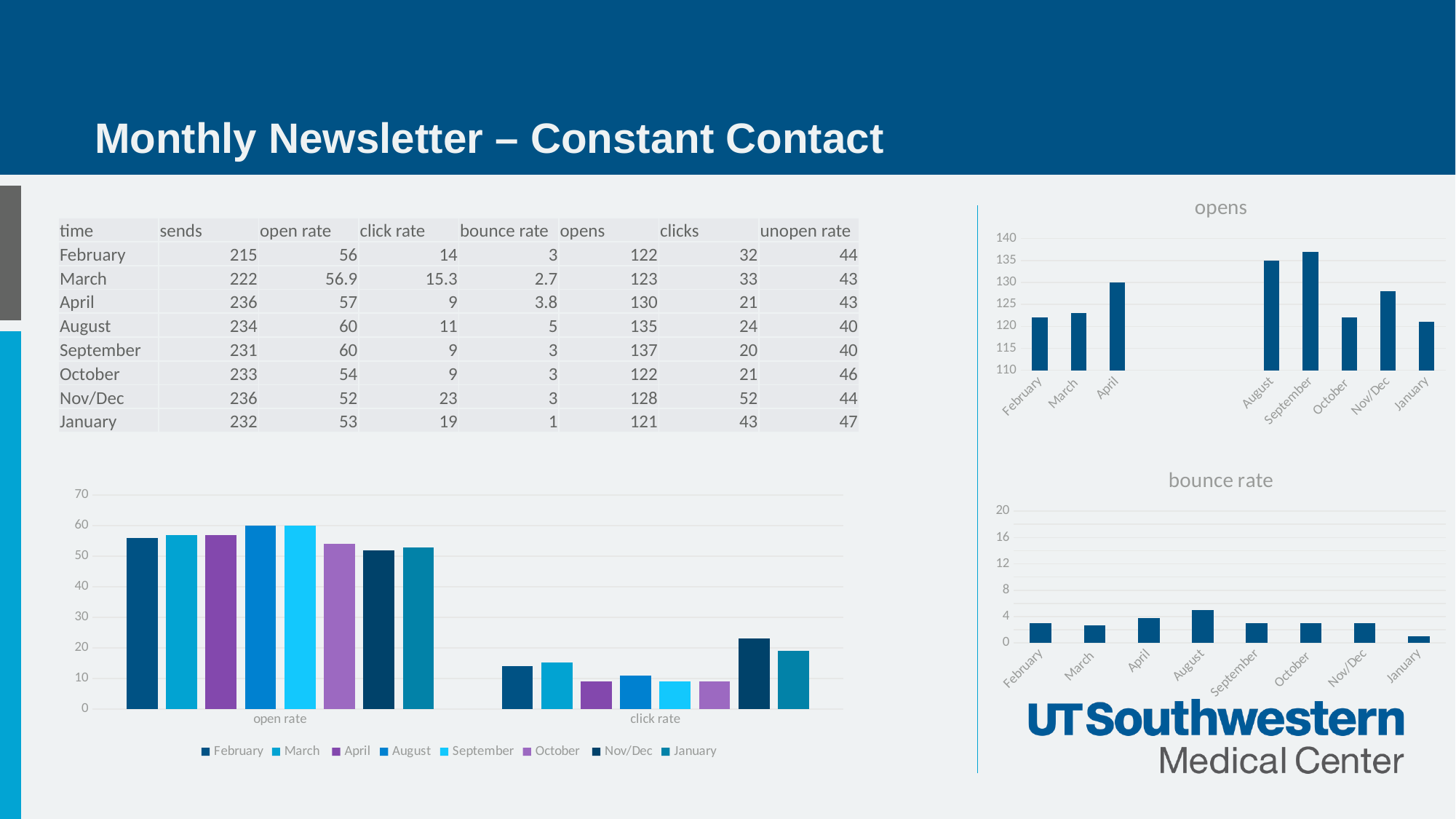
In the 'bounce rate' chart, which month has the highest value? August In the bottom-left chart, what is the open rate value for August? 60 In the 'opens' chart, which is larger, the value for April or the value for February? April In the 'bounce rate' chart, which month has the lowest value? January How many series does the legend of the bottom-left chart list? 8 What kind of chart is the 'opens' chart at the top right? bar chart In the bottom-left chart, which month has the highest click rate? Nov/Dec In the 'bounce rate' chart, is the value for August greater or less than 4? greater In the 'opens' chart, which month has the highest value? September In the 'opens' chart, is the value for Nov/Dec greater or less than 125? greater How many months are plotted in the 'opens' chart? 8 In the 'opens' chart, what is the value for August? 135